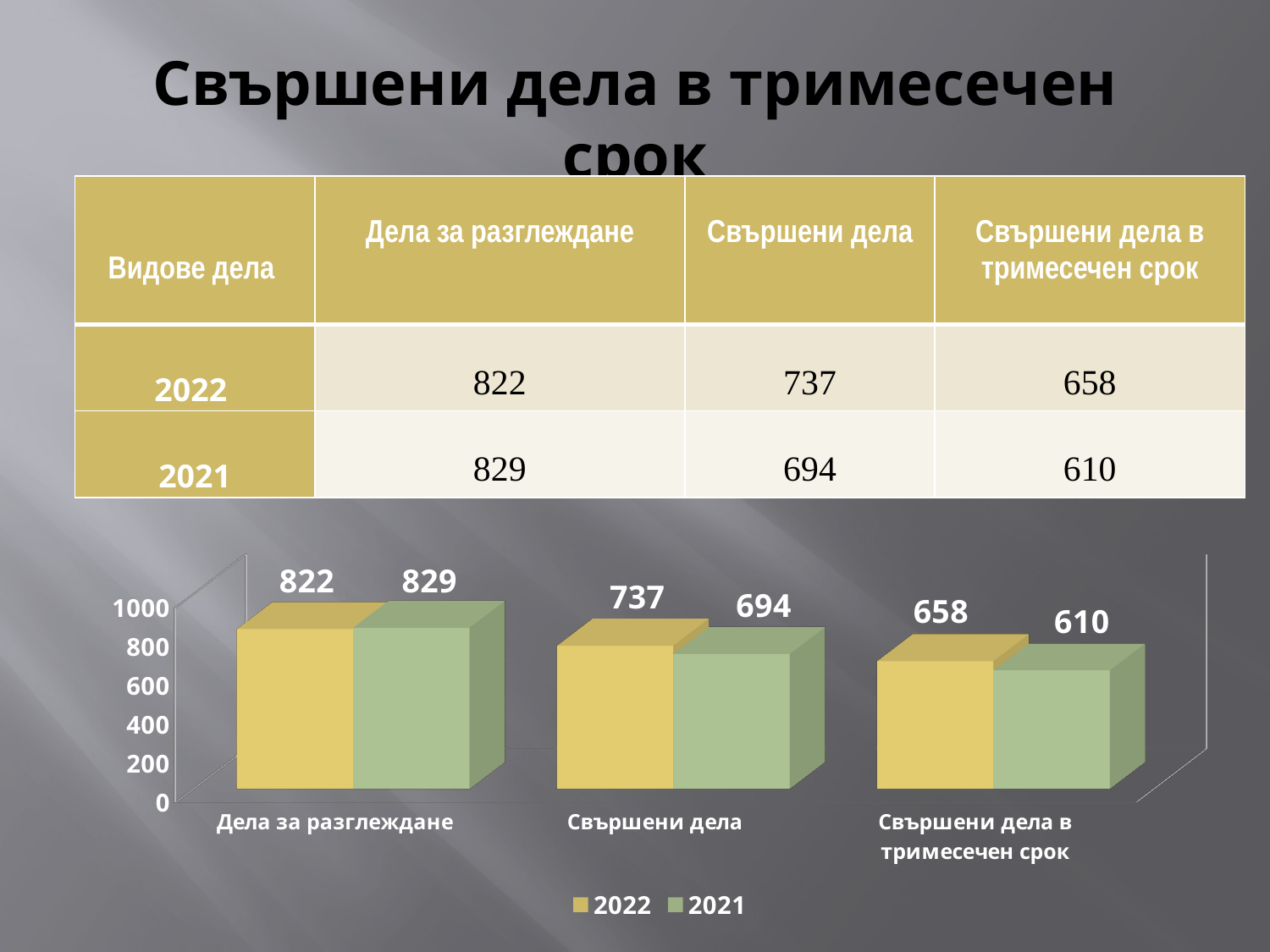
Which category has the highest value for the 2022 series? Дела за разглеждане What is the value for 2021 in the "Свършени дела" category? 694 Which is larger in the "Дела за разглеждане" category, the 2022 value or the 2021 value? 2021 What is the value for 2022 in the "Дела за разглеждане" category? 822 What kind of chart is shown on the slide? Bar chart Which category has the lowest value for the 2021 series? Свършени дела в тримесечен срок What is the value for 2022 in the "Свършени дела в тримесечен срок" category? 658 How many categories are shown on the x axis of the chart? 3 What is the difference between the 2022 and 2021 values in the "Свършени дела" category? 43 What is the value for 2021 in the "Дела за разглеждане" category? 829 How many series does the chart legend list? 2 What is the difference between the 2022 and 2021 values in the "Свършени дела в тримесечен срок" category? 48